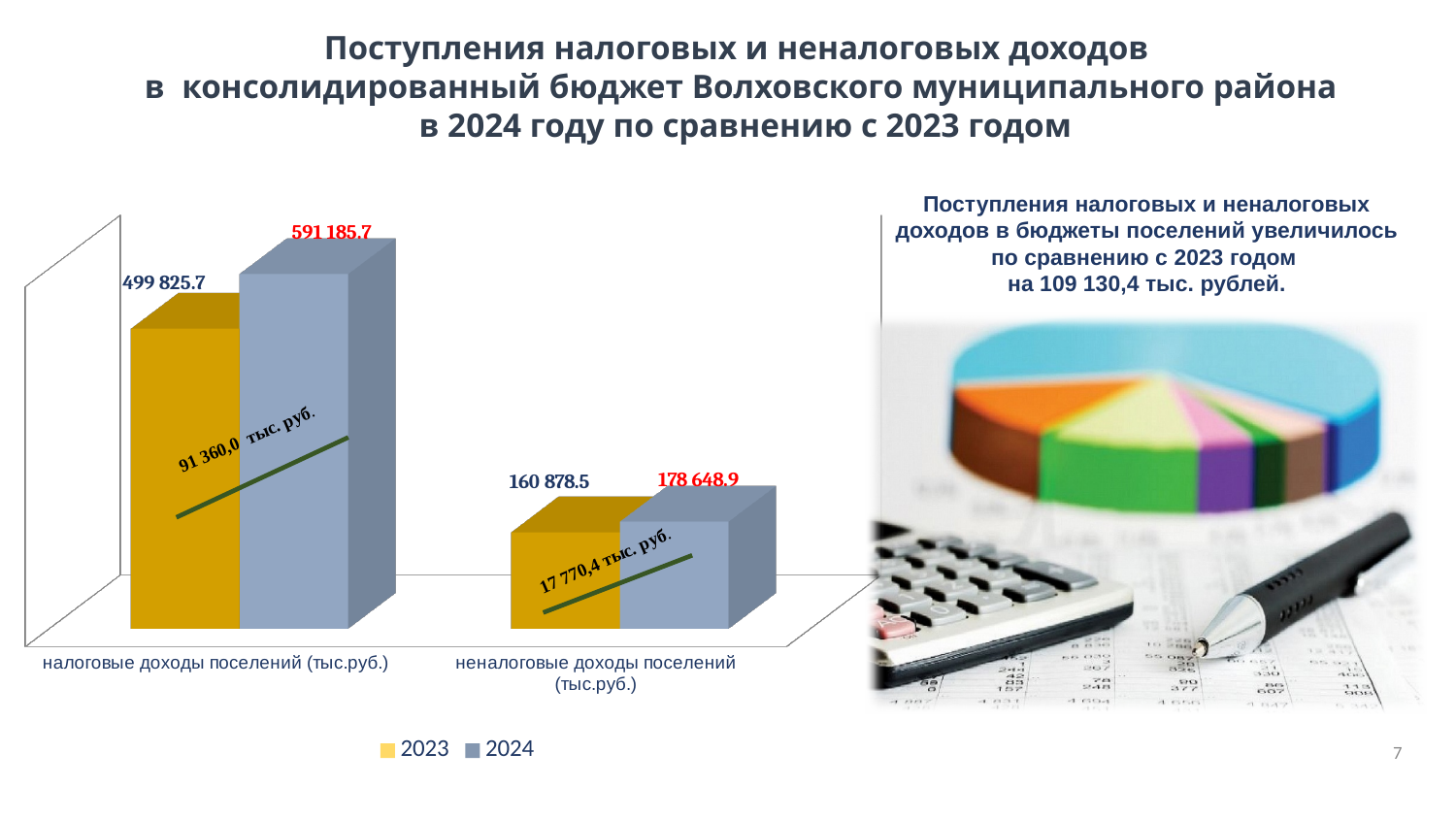
What kind of chart is shown on the left of the slide? Bar chart What is the value for 2023 in the category "налоговые доходы поселений (тыс.руб.)"? 499 825.7 What is the difference between the 2024 and 2023 values for "неналоговые доходы поселений (тыс.руб.)"? 17 770.4 What is the value for 2024 in the category "неналоговые доходы поселений (тыс.руб.)"? 178 648.9 What is the difference between the 2024 and 2023 values for "налоговые доходы поселений (тыс.руб.)"? 91 360.0 What is the value for 2023 in the category "неналоговые доходы поселений (тыс.руб.)"? 160 878.5 How many series does the legend of the chart list? 2 Which is larger: the 2023 value for "налоговые доходы поселений" or the 2024 value for "неналоговые доходы поселений"? 2023 value for налоговые доходы поселений How many categories are shown on the x axis of the bar chart? 2 What is the value for 2024 in the category "налоговые доходы поселений (тыс.руб.)"? 591 185.7 Which bar in the chart has the lowest value? 2023, неналоговые доходы поселений (тыс.руб.) Which bar in the chart has the highest value? 2024, налоговые доходы поселений (тыс.руб.)